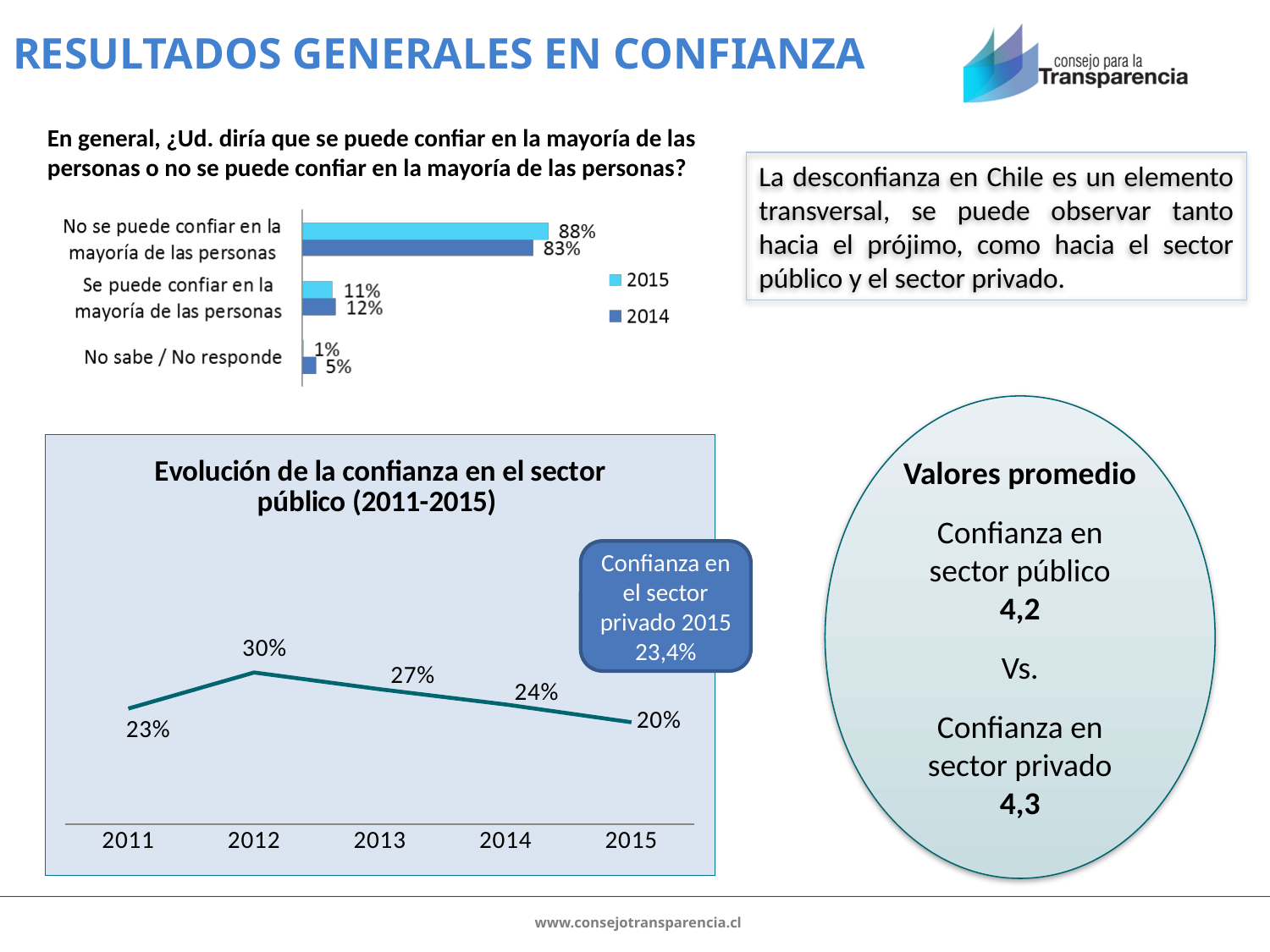
In the top-left bar chart, what is the 2015 value for "No se puede confiar en la mayoría de las personas"? 88% In the chart "Evolución de la confianza en el sector público (2011-2015)", how many years are plotted? 5 In the top-left bar chart, what is the 2014 value for "No sabe / No responde"? 5% In the top-left bar chart, what is the difference between the 2015 and 2014 values for "No se puede confiar en la mayoría de las personas"? 5% In the top-left bar chart, what is the 2014 value for "Se puede confiar en la mayoría de las personas"? 12% In the chart "Evolución de la confianza en el sector público (2011-2015)", what is the difference between the 2012 and 2015 values? 10% In the chart "Evolución de la confianza en el sector público (2011-2015)", do the values rise or fall from 2012 to 2015? Fall In the chart "Evolución de la confianza en el sector público (2011-2015)", what is the value for 2012? 30% In the chart "Evolución de la confianza en el sector público (2011-2015)", which year has the lowest value? 2015 What kind of chart is the top-left chart? Bar chart In the top-left bar chart, how many series does the legend list? 2 In the top-left bar chart, which category has the highest value in 2015? No se puede confiar en la mayoría de las personas